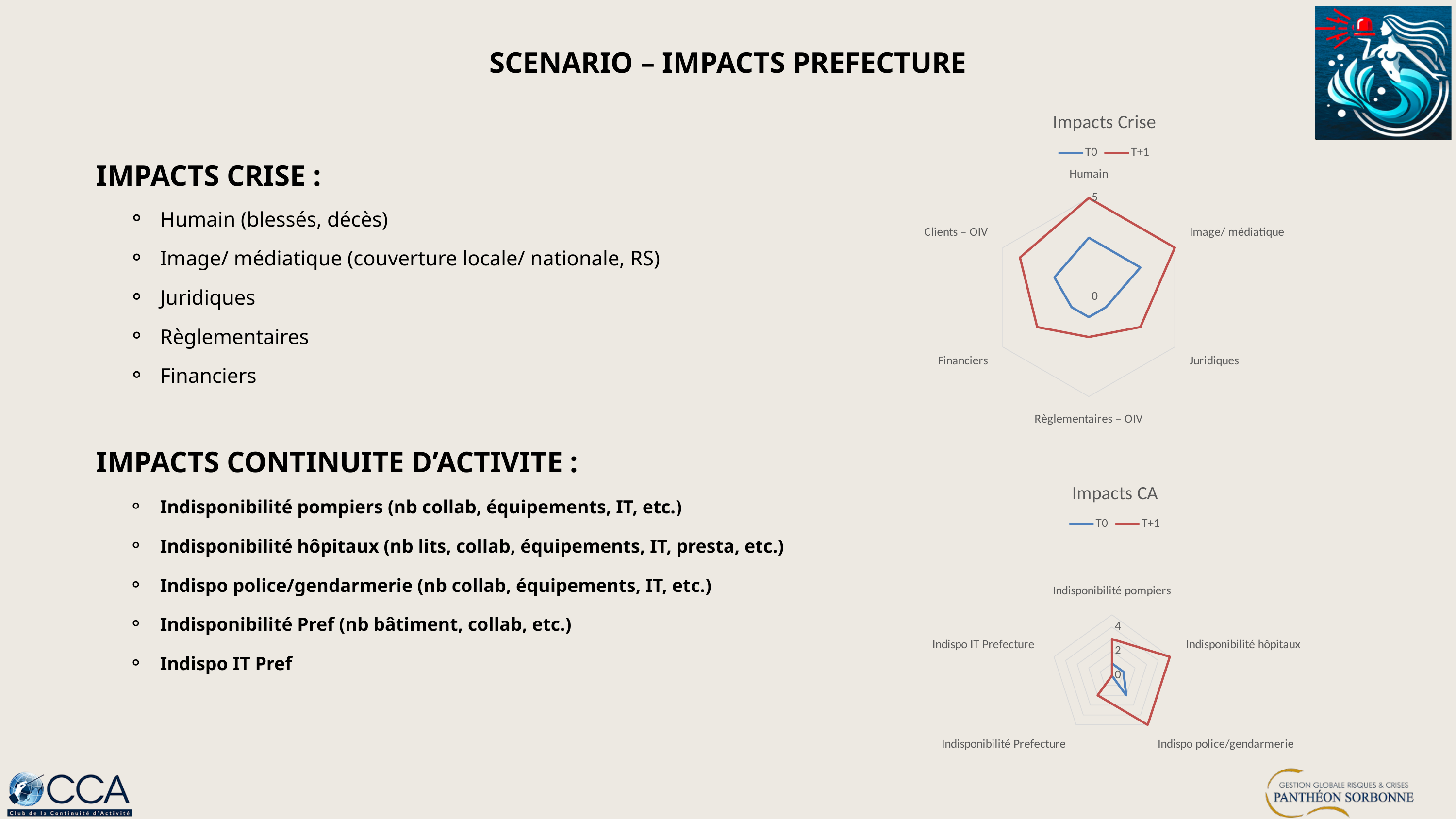
How many categories (axes) does the 'Impacts CA' chart have? 5 What are the two series named in the legend of the 'Impacts CA' chart? T0 and T+1 In the 'Impacts CA' chart, which series has the larger value for Indispo police/gendarmerie, T0 or T+1? T+1 In the 'Impacts CA' chart, is the T+1 value for Indisponibilité pompiers greater or less than 2? greater How many categories (axes) does the 'Impacts Crise' chart have? 6 What kind of chart is the 'Impacts Crise' chart? Radar chart In the 'Impacts CA' chart, is the T+1 value for Indisponibilité hôpitaux greater or less than 2? greater In the 'Impacts CA' chart, is the T0 value for Indisponibilité pompiers greater or less than 2? less How many series does the legend of the 'Impacts Crise' chart list? 2 In the 'Impacts Crise' chart, which series has the larger value for Humain, T0 or T+1? T+1 In the 'Impacts Crise' chart, what is the T+1 value for Humain? 5 What kind of chart is the 'Impacts CA' chart? Radar chart